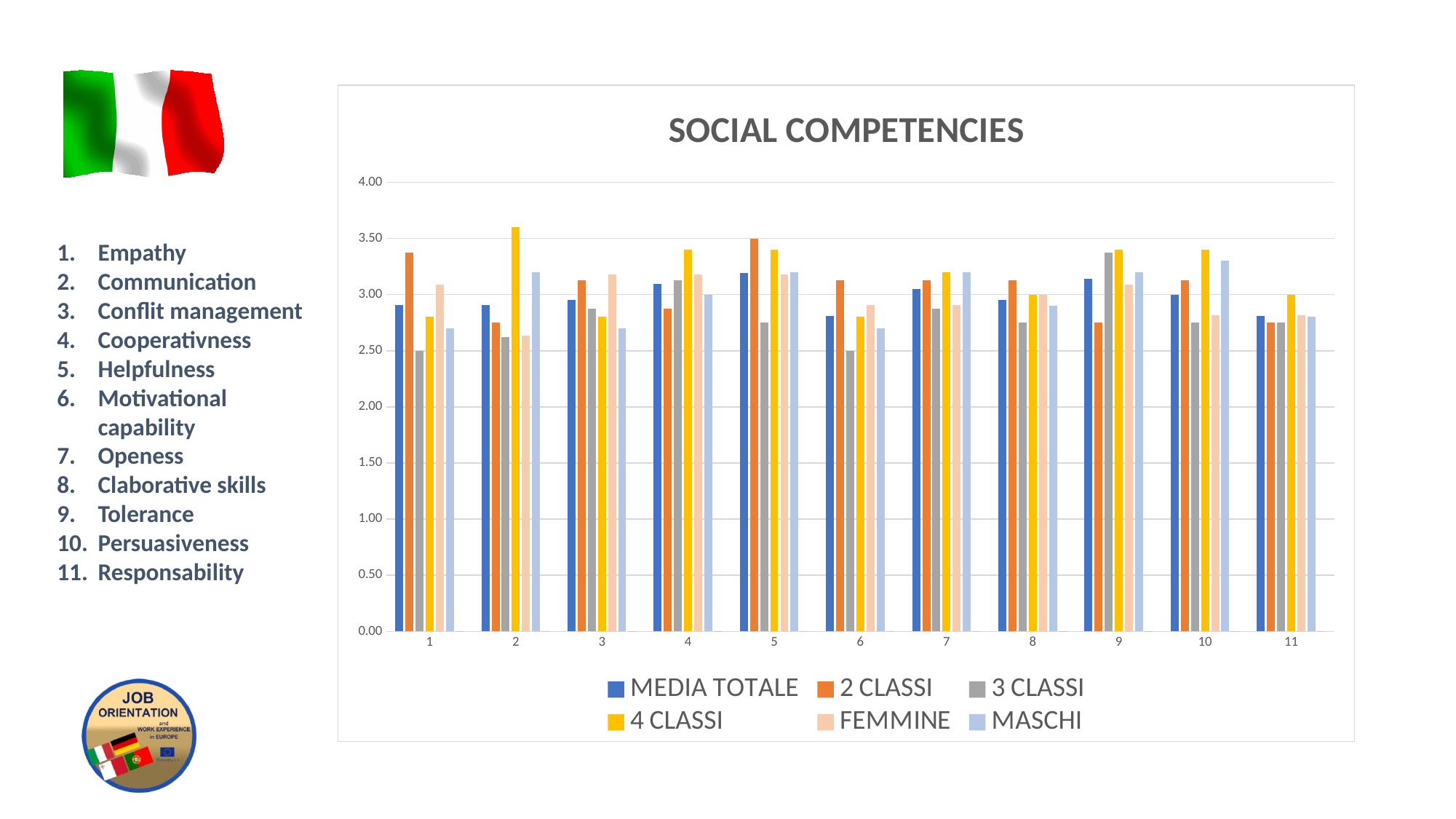
How many series does the legend of the SOCIAL COMPETENCIES chart list? 6 At category 9, which is larger: the 3 CLASSI value or the 2 CLASSI value? 3 CLASSI At category 5, which is larger: the 2 CLASSI value or the 3 CLASSI value? 2 CLASSI Is the 3 CLASSI value for category 1 greater or less than 3.00? less Is the MASCHI value for category 10 greater or less than 3.00? greater Is the 4 CLASSI value for category 2 greater or less than 3.50? greater Which colour represents the MEDIA TOTALE series in the legend? Blue How many categories are shown along the x axis of the chart? 11 What kind of chart is shown on the slide? Bar chart For which category is the 4 CLASSI bar the highest? 2 What is the title of the chart? SOCIAL COMPETENCIES